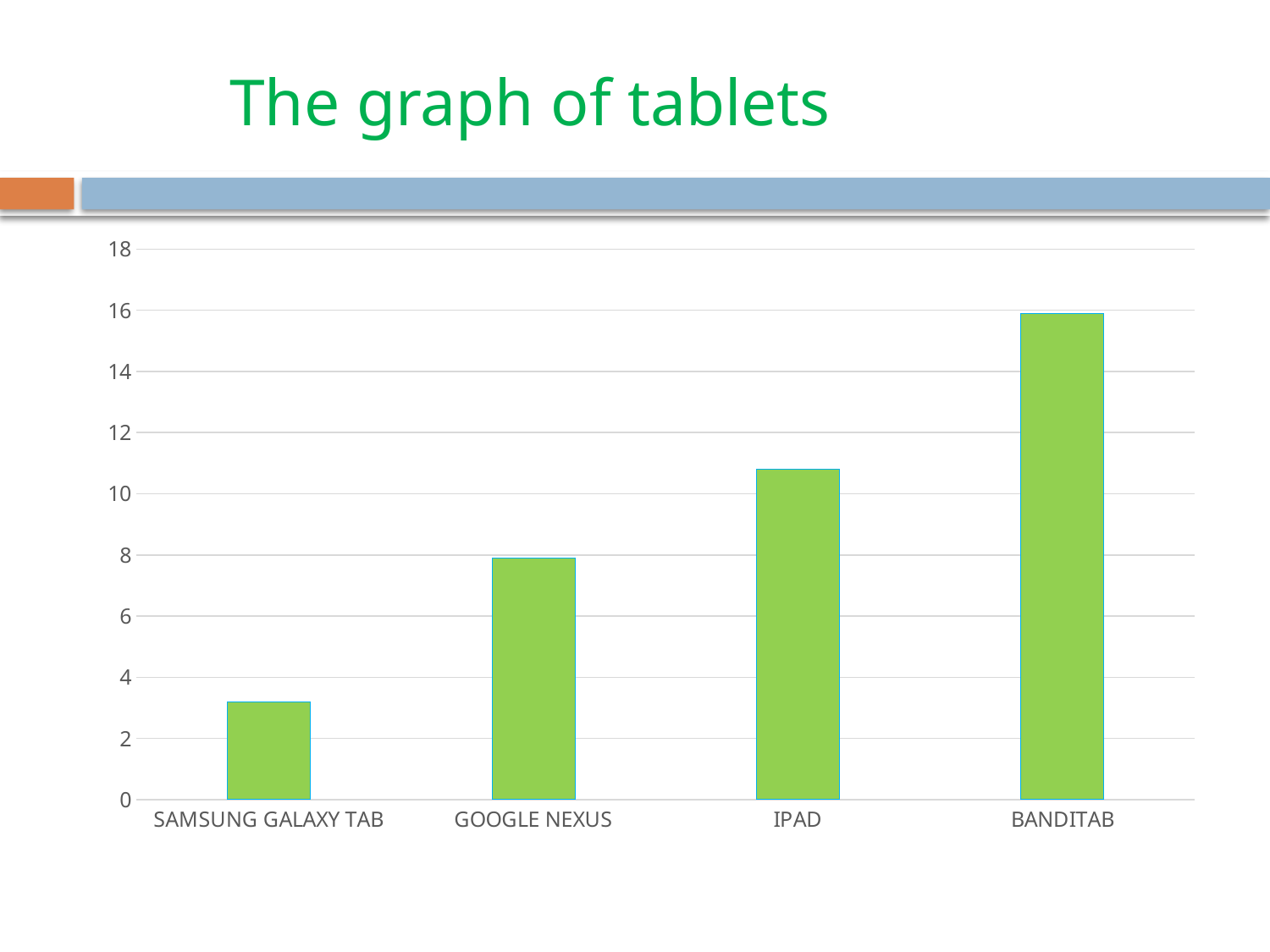
Do the values rise or fall from left to right along the x axis? rise Which has the larger value, SAMSUNG GALAXY TAB or BANDITAB? BANDITAB How many tablets are shown on the x axis of the chart? 4 Is the value for IPAD greater or less than 10? greater What is the title of the slide containing the chart? The graph of tablets Which tablet has the lowest bar in the chart? SAMSUNG GALAXY TAB Is the value for SAMSUNG GALAXY TAB greater or less than 4? less Is the value for GOOGLE NEXUS greater or less than 6? greater What kind of chart is shown on the slide? bar chart Which tablet has the highest bar in the chart? BANDITAB Which has the larger value, IPAD or GOOGLE NEXUS? IPAD